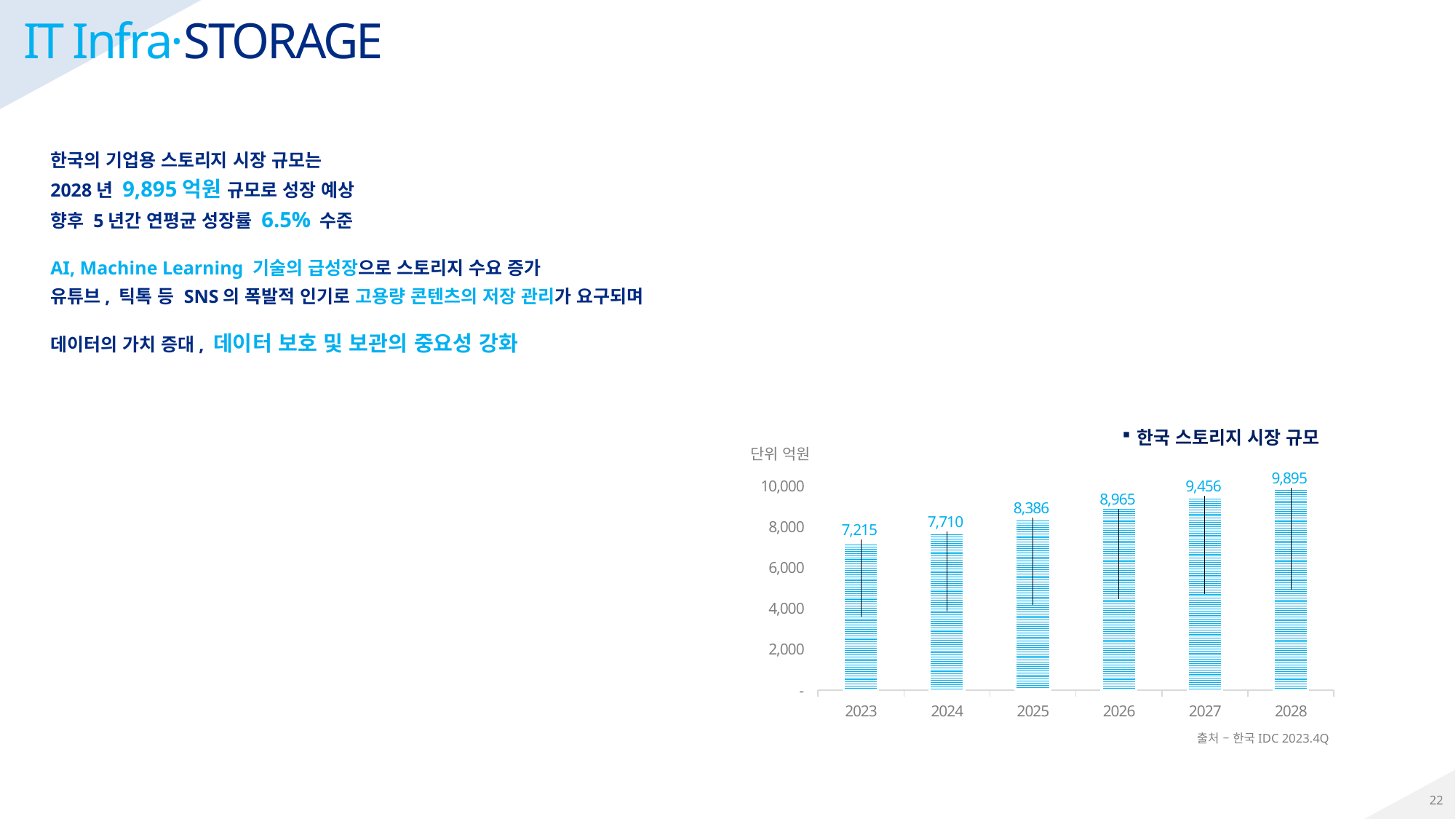
Do the values rise or fall from 2023 to 2028? rise Which year has the highest value? 2028 What is the value for 2023? 7,215 How many years are shown on the x axis? 6 What is the value for 2026? 8,965 Which year has the lowest value? 2023 Is the value for 2024 greater or less than 8,000? less What is the difference between the values for 2028 and 2023? 2,680 What is the difference between the values for 2025 and 2024? 676 What kind of chart is shown on the slide? bar chart Which is larger, the value for 2027 or the value for 2025? 2027 What is the value for 2028? 9,895